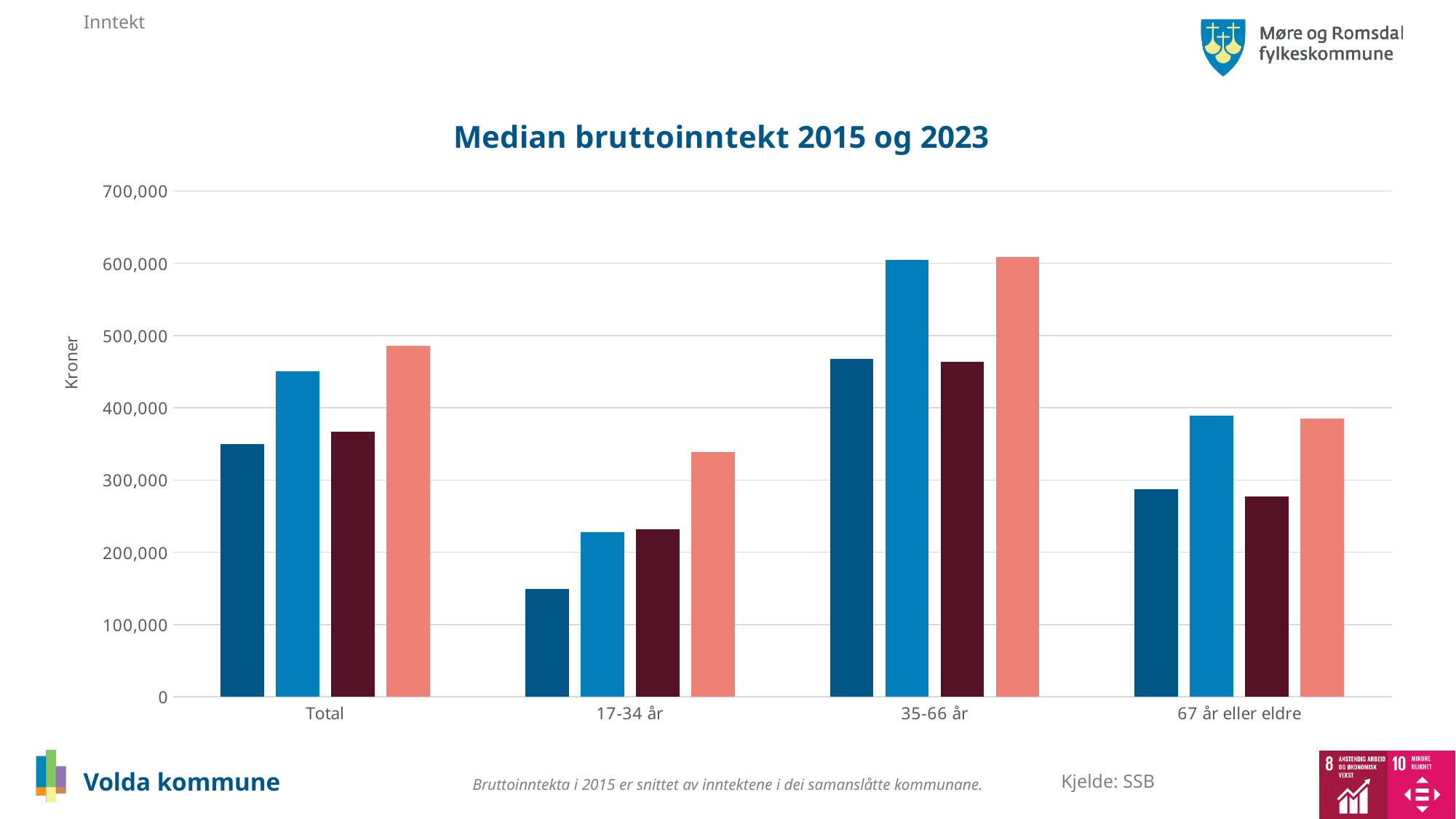
Which category has the tallest bars in the chart? 35-66 år Which category has the lowest bars in the chart? 17-34 år What is the label on the vertical axis of the chart? Kroner How many bars are plotted for each category in the chart? 4 Is the value of the third (dark red) bar for 67 år eller eldre greater or less than 300,000? less What kind of chart is shown on the slide? bar chart For 67 år eller eldre, which is taller: the light blue bar or the dark red bar? the light blue bar Is the value of the first (dark blue) bar for 17-34 år greater or less than 200,000? less Is the value of the fourth (salmon) bar for 17-34 år greater or less than 300,000? greater How many categories are shown along the x axis of the chart? 4 What is the title of the chart? Median bruttoinntekt 2015 og 2023